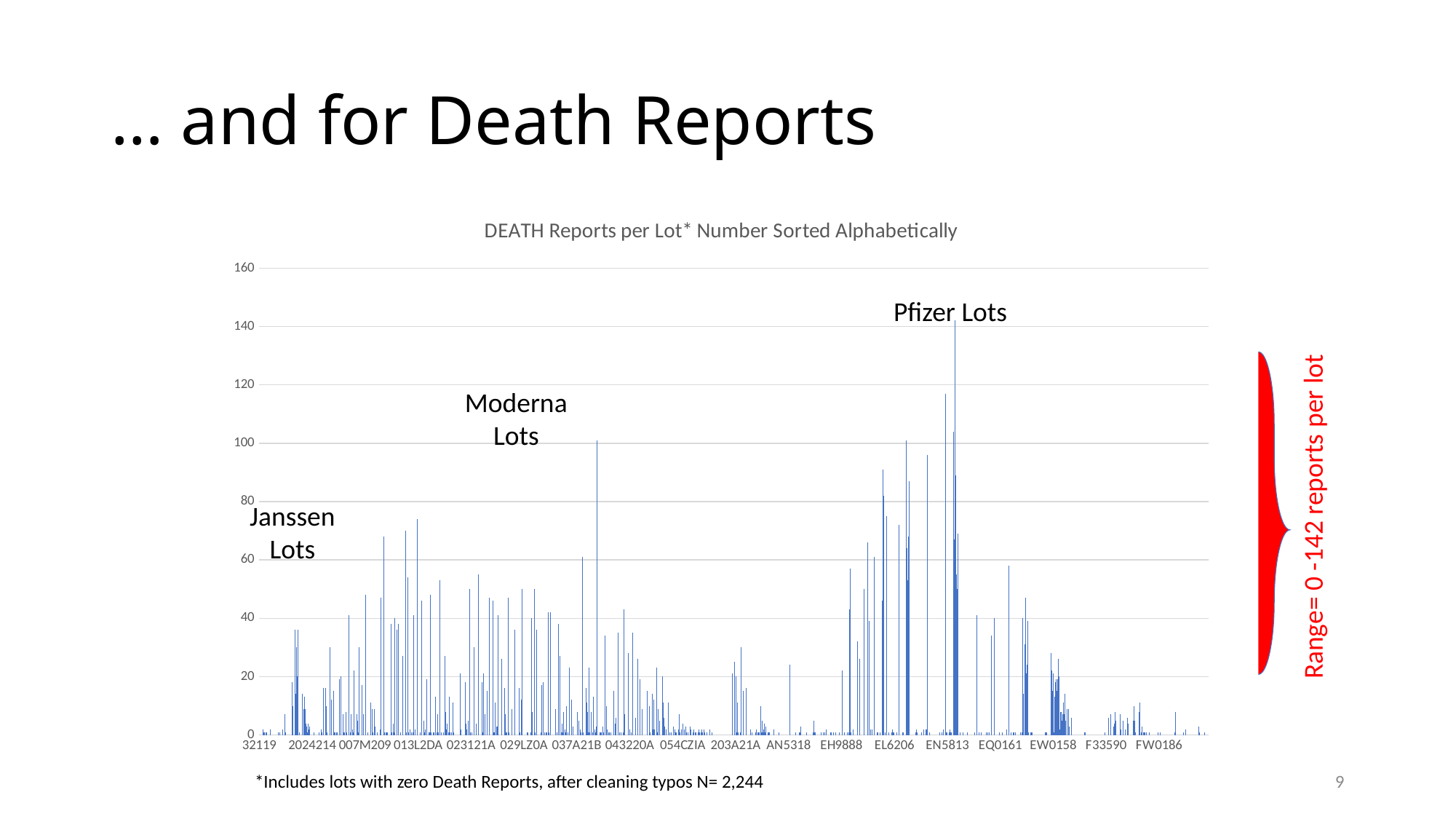
What is the highest value shown on the vertical axis? 160 Which group has a taller maximum bar, Janssen Lots or Pfizer Lots? Pfizer Lots Is the tallest bar among the Janssen Lots greater or less than 80? less What is the title of the chart? DEATH Reports per Lot* Number Sorted Alphabetically Is the tallest bar among the Pfizer Lots greater or less than 120? greater Which group has a taller maximum bar, Janssen Lots or Moderna Lots? Moderna Lots What kind of chart is shown on the slide? bar chart What is the highest number of death reports for any single lot, as stated on the slide? 142 Which group of lots (Janssen, Moderna or Pfizer) contains the tallest bar in the chart? Pfizer Lots According to the annotation on the slide, what is the range of death reports per lot? 0 -142 reports per lot How many lots are included in the chart, according to the footnote? 2,244 Is the tallest bar among the Moderna Lots greater or less than 120? less